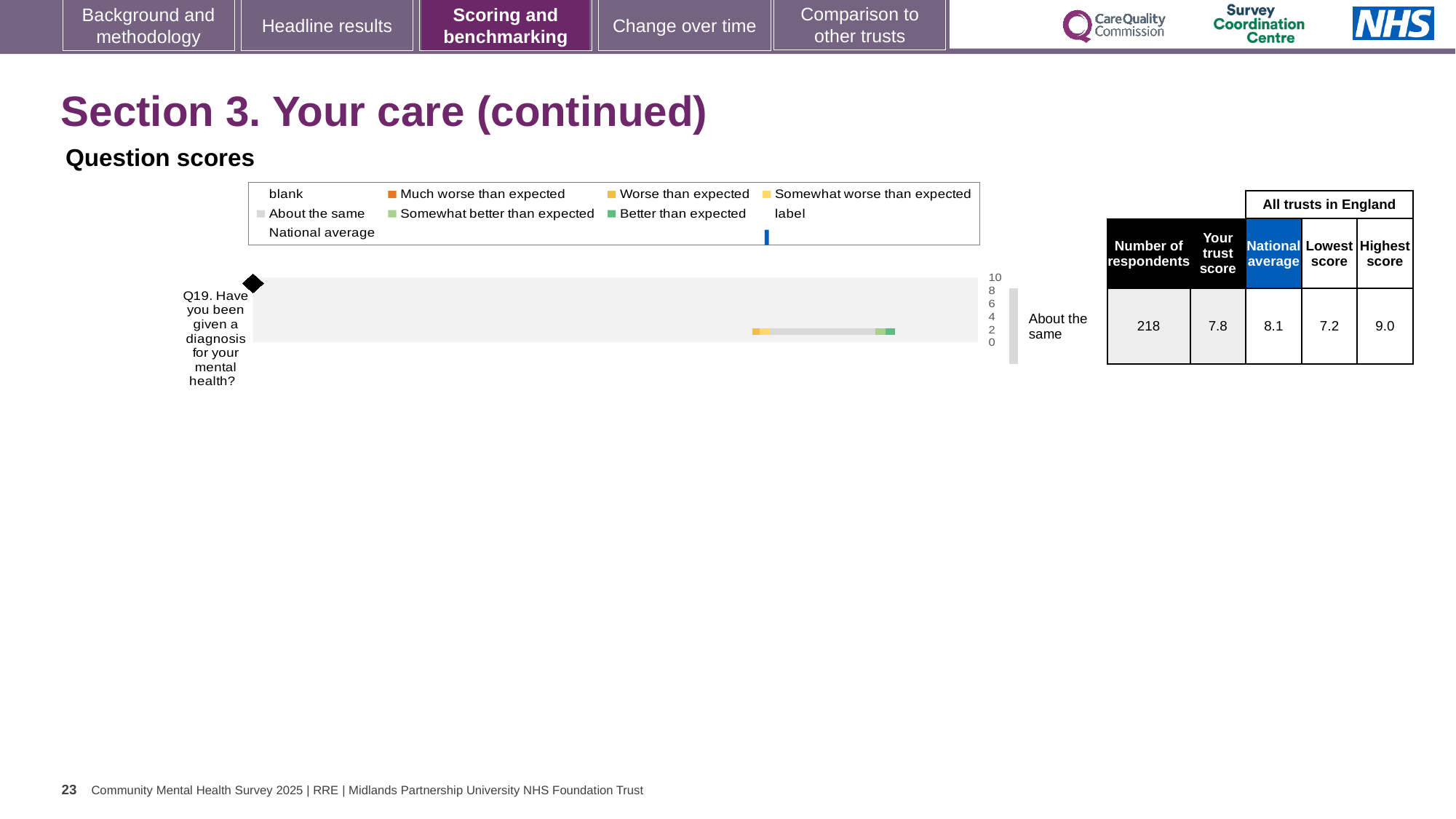
Which survey question is plotted in the bar chart? Q19. Have you been given a diagnosis for your mental health? By how much does the national average exceed the trust score for Q19? 0.3 What is the difference between the highest and lowest scores for Q19 across all trusts in England? 1.8 What is the lowest score among all trusts in England for Q19? 7.2 What benchmark category is shown next to the Q19 bar? About the same How many survey questions are plotted in the chart? 1 What is the trust's score for Q19? 7.8 What is the national average score for Q19? 8.1 What is the highest score among all trusts in England for Q19? 9.0 How many respondents answered Q19? 218 What kind of chart is shown under 'Question scores'? bar chart Which is larger for Q19, the trust score or the national average? National average